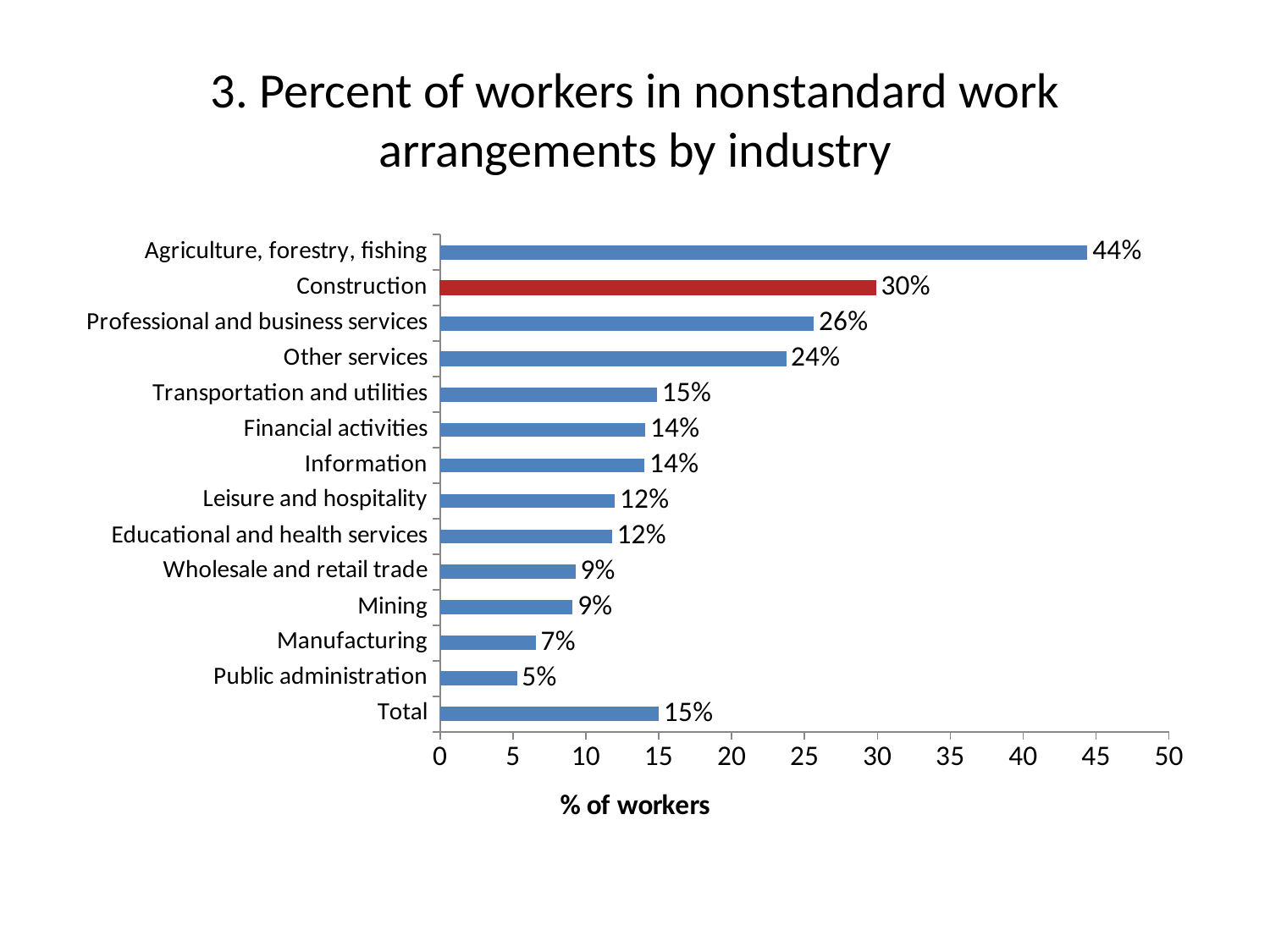
What is the difference between the values for Agriculture, forestry, fishing and Construction? 14% Is the value for Professional and business services greater or less than 25? greater Which is larger, the value for Other services or the value for Transportation and utilities? Other services What is the value for Total? 15% Which category's bar is coloured red instead of blue? Construction Which industry has the highest percent of workers in nonstandard work arrangements? Agriculture, forestry, fishing What kind of chart is shown on the slide? Bar chart What is the label of the horizontal axis? % of workers Which category has the lowest value? Public administration What is the value for Construction? 30% What is the value for Public administration? 5% How many categories are shown on the chart? 14